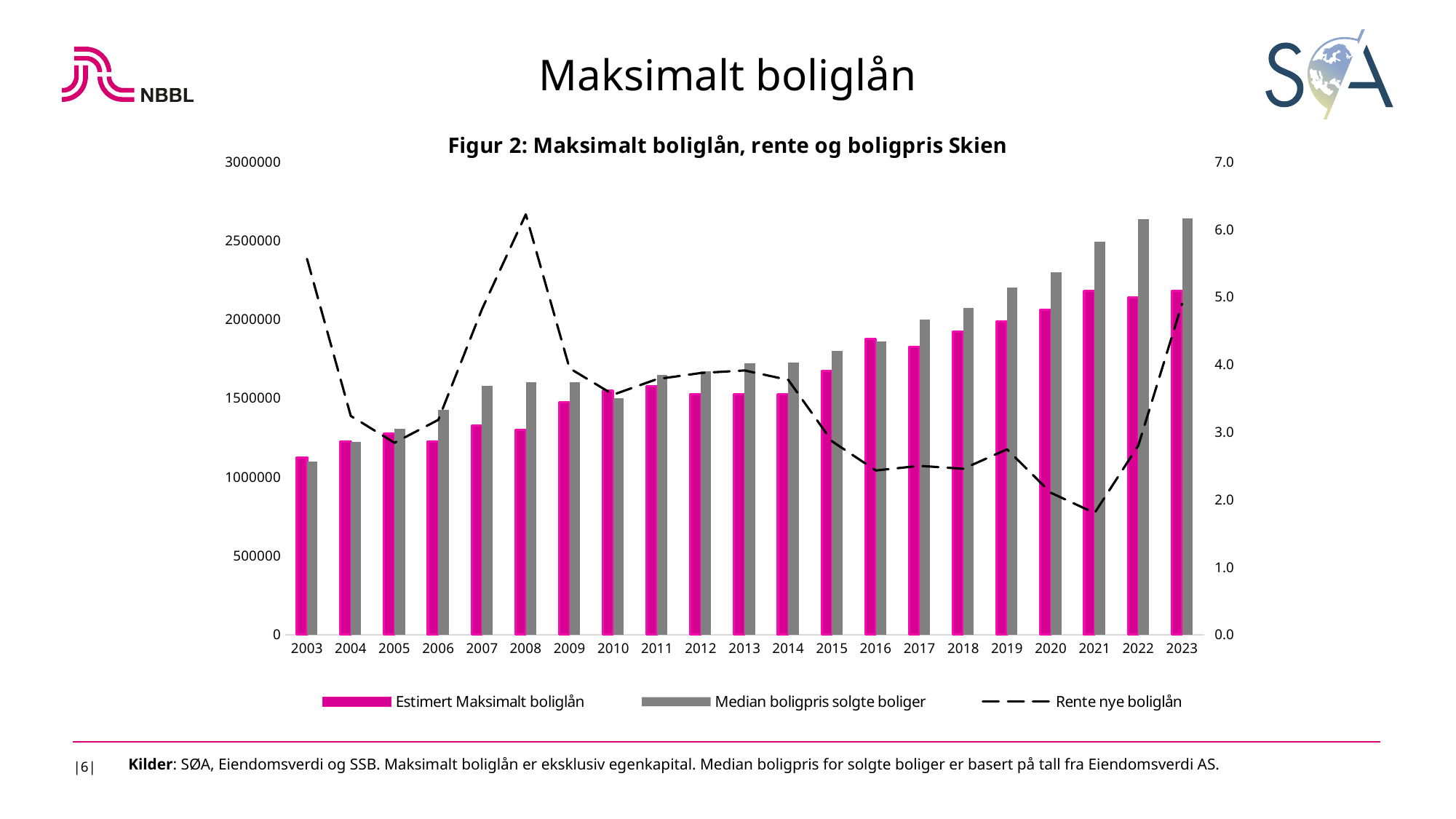
Is the value for Rente nye boliglån in 2008 greater or less than 5.0? greater How many years are shown on the x axis? 21 What kind of chart is shown on the slide? A bar chart combined with a dashed line How many series does the legend list? 3 In 2023, which is larger: Estimert Maksimalt boliglån or Median boligpris solgte boliger? Median boligpris solgte boliger Does Median boligpris solgte boliger generally rise or fall from 2003 to 2023? rise In which year does Rente nye boliglån reach its highest value? 2008 Which year has the lowest value for Median boligpris solgte boliger? 2003 Which year has the lowest value for Estimert Maksimalt boliglån? 2003 Is the value for Median boligpris solgte boliger in 2023 greater or less than 2500000? greater In which year does Rente nye boliglån reach its lowest value? 2021 Is the value for Rente nye boliglån in 2021 greater or less than 2.0? less